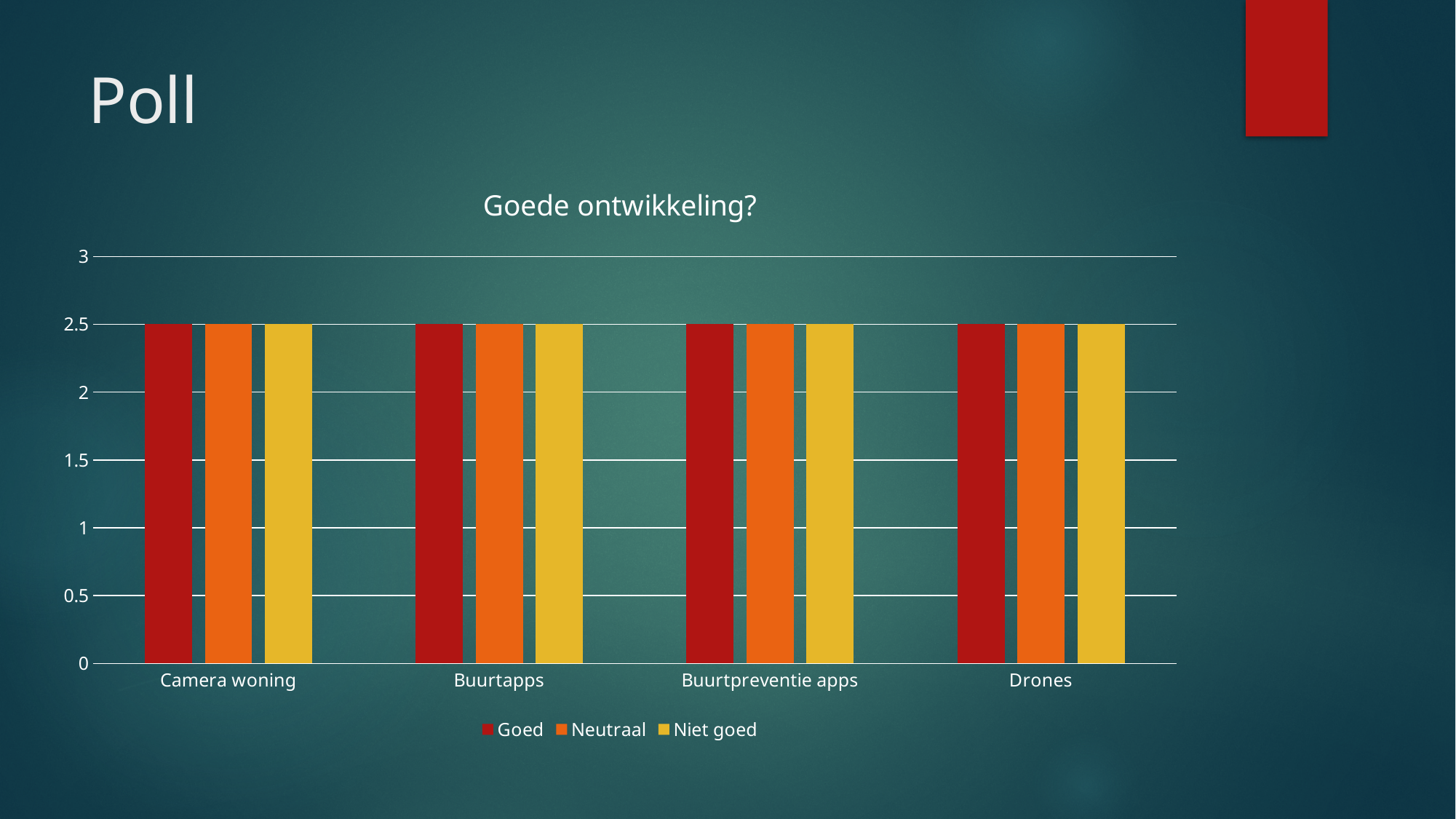
Which series is shown in yellow in the legend? Niet goed Is the value for Neutraal in the Drones category greater or less than 2? greater How many categories are shown on the x axis? 4 What type of chart is shown on the slide? bar chart What is the difference between the Goed value for Buurtapps and the Goed value for Drones? 0 What is the value for Goed in the Buurtpreventie apps category? 2.5 What is the value for Neutraal in the Buurtapps category? 2.5 How many series does the legend list? 3 What is the value for Niet goed in the Drones category? 2.5 What is the value for Goed in the Camera woning category? 2.5 Is the value for Niet goed in the Camera woning category greater or less than 3? less What is the title of the chart? Goede ontwikkeling?